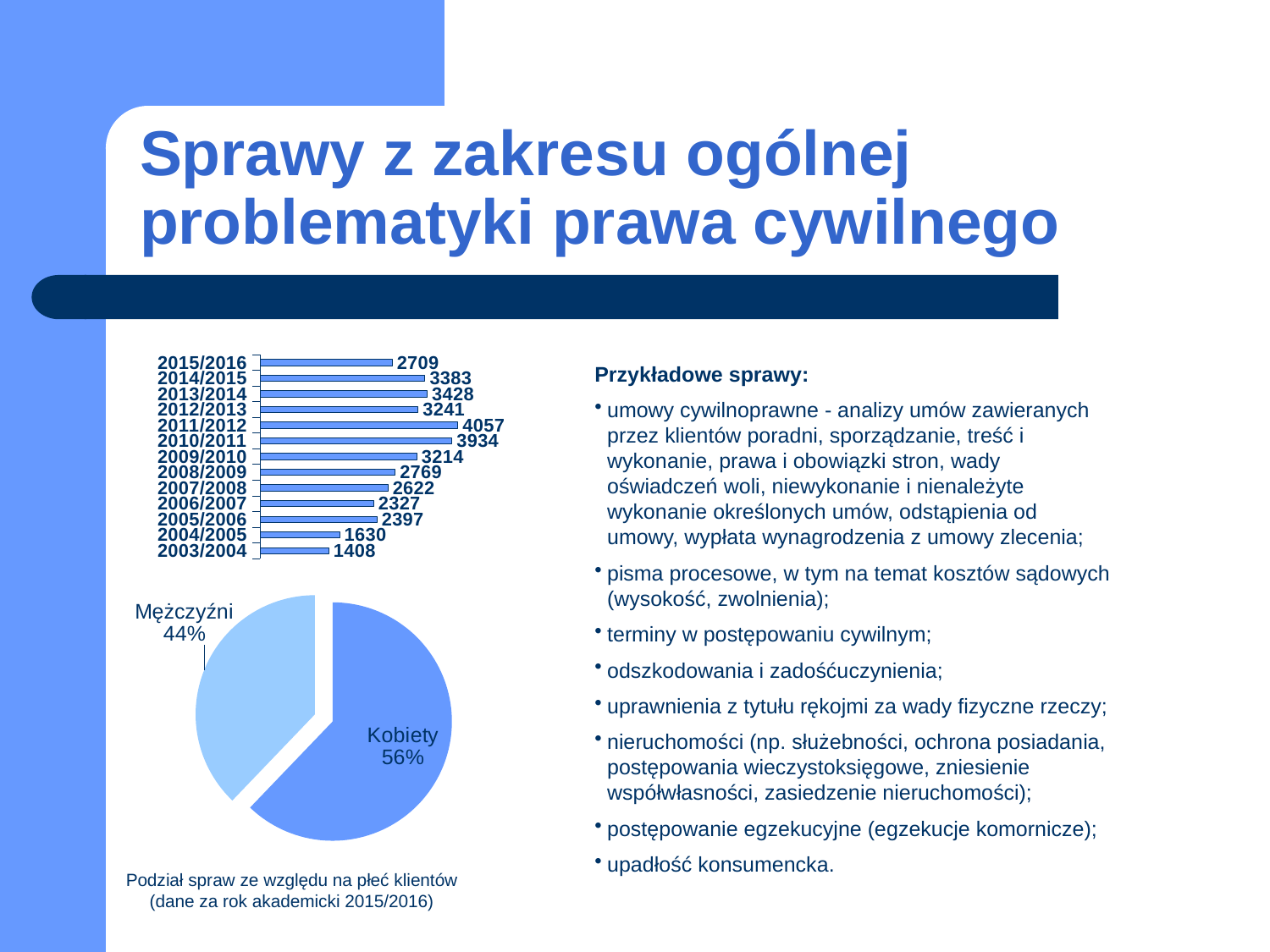
In the bar chart at the top left, what is the difference between the values for 2004/2005 and 2003/2004? 222 In the pie chart titled 'Podział spraw ze względu na płeć klientów', what share is Kobiety? 56% What kind of chart is the chart at the top left of the slide? Bar chart In the bar chart at the top left, what is the difference between the values for 2011/2012 and 2003/2004? 2649 In the bar chart at the top left, what is the value for 2015/2016? 2709 In the pie chart titled 'Podział spraw ze względu na płeć klientów', what share is Mężczyźni? 44% In the bar chart at the top left, which year has the highest value? 2011/2012 In the bar chart at the top left, how many years are shown? 13 In the bar chart at the top left, what is the value for 2011/2012? 4057 In the bar chart at the top left, which year has the lowest value? 2003/2004 In the pie chart titled 'Podział spraw ze względu na płeć klientów', which academic year does the caption say the data is for? 2015/2016 In the bar chart at the top left, which is larger, the value for 2013/2014 or the value for 2014/2015? 2013/2014